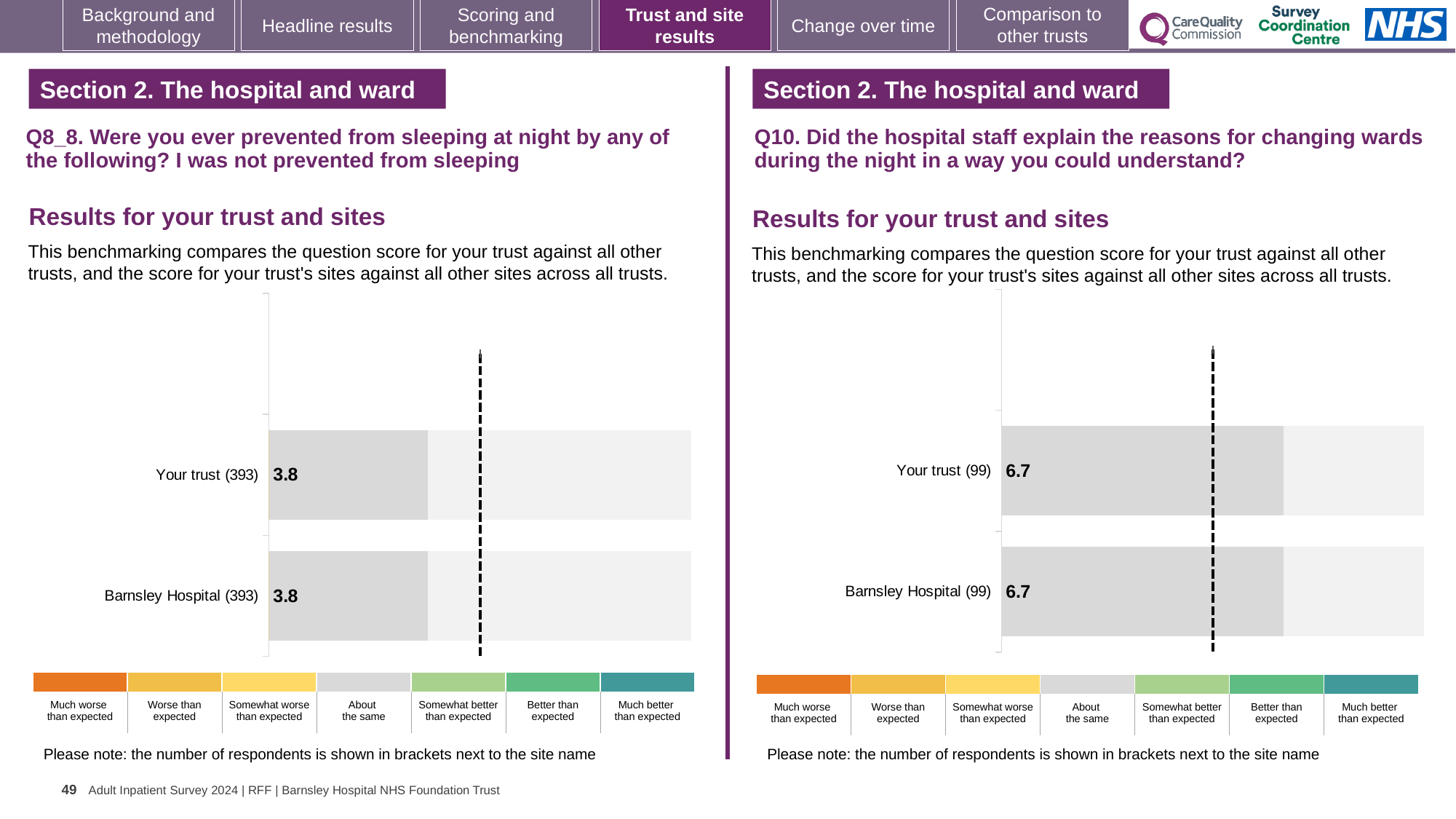
What kind of chart is used on the left side of the slide (Q8_8)? Bar chart How many bars are plotted in the left chart (Q8_8)? 2 In the left chart (Q8_8), how many respondents are shown in brackets next to Your trust? 393 In the right chart (Q10), what is the score for Your trust? 6.7 In the left chart (Q8_8), what is the score for Your trust? 3.8 In the right chart (Q10), what is the score for Barnsley Hospital? 6.7 In the right chart (Q10), how many respondents are shown in brackets next to Barnsley Hospital? 99 In the left chart (Q8_8), what is the score for Barnsley Hospital? 3.8 How many bars are plotted in the right chart (Q10)? 2 In the left chart (Q8_8), what is the difference between the score for Your trust and the score for Barnsley Hospital? 0 In the right chart (Q10), what is the difference between the score for Your trust and the score for Barnsley Hospital? 0